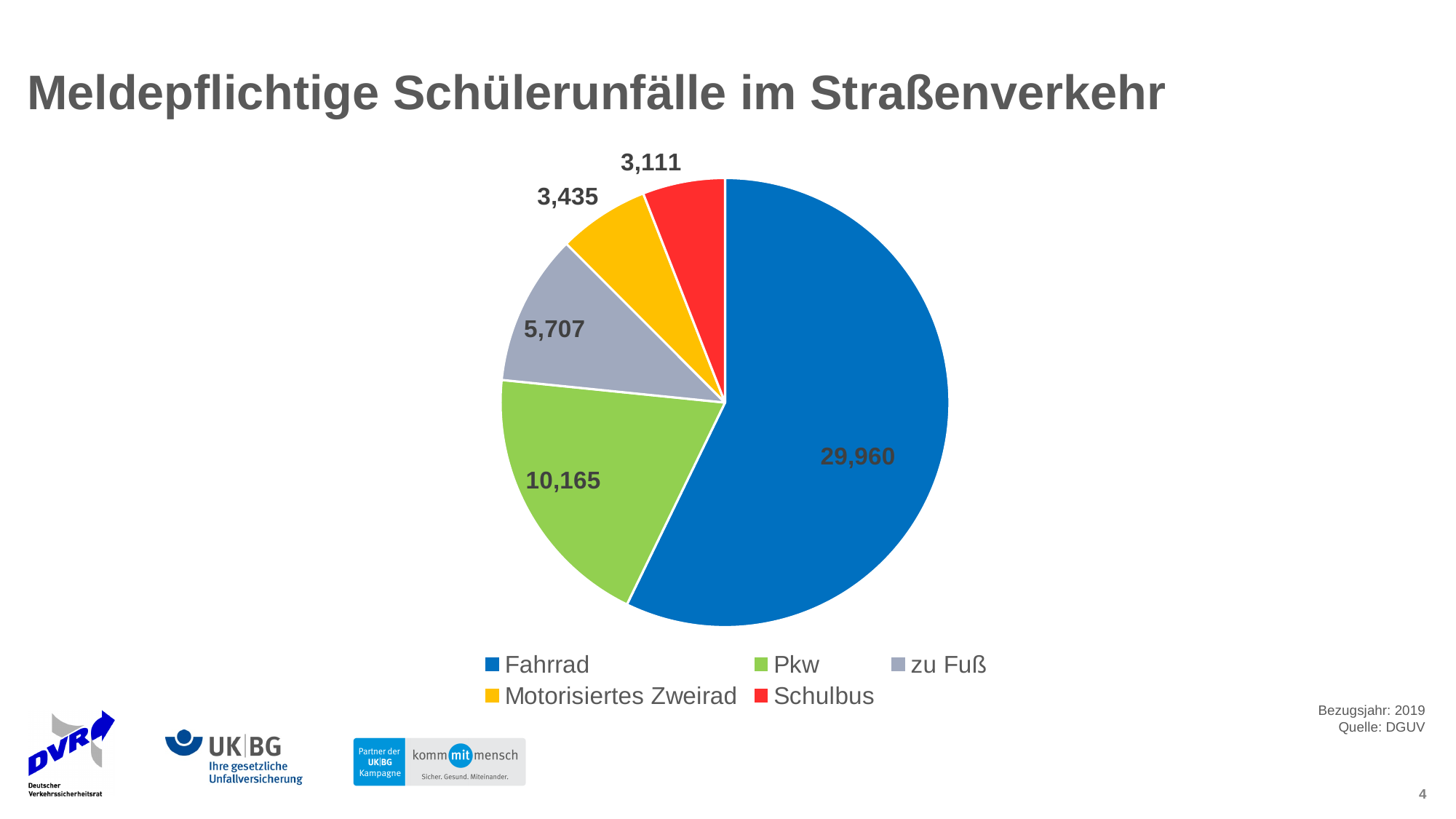
What value is shown for the Pkw slice? 10,165 What is the difference between the Fahrrad value and the Pkw value? 19,795 What value is shown for the Schulbus slice? 3,111 Which category has the smallest slice? Schulbus What value is shown for the Fahrrad slice? 29,960 What kind of chart is shown on the slide? Pie chart What is the title of the chart on the slide? Meldepflichtige Schülerunfälle im Straßenverkehr Which category has the largest slice? Fahrrad Which is larger, the value for Pkw or the value for zu Fuß? Pkw What is the difference between the Motorisiertes Zweirad value and the Schulbus value? 324 How many categories does the pie chart show? 5 What value is shown for the zu Fuß slice? 5,707